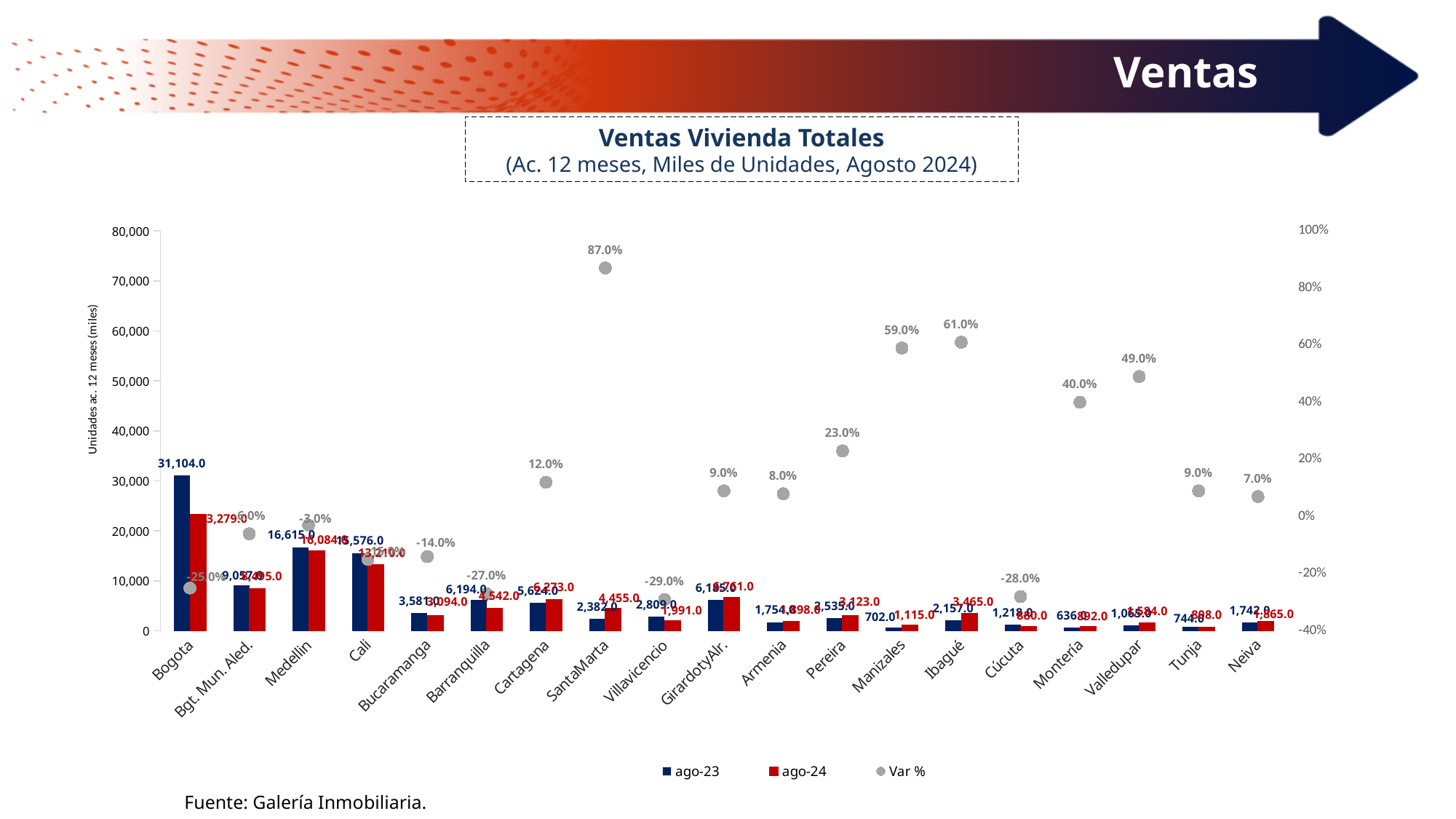
Which city has the highest ago-23 value? Bogota How many series does the legend list? 3 For Cartagena, which is larger: the ago-23 value or the ago-24 value? ago-24 What is the Var % value for SantaMarta? 87.0% What is the source cited below the chart? Galería Inmobiliaria What is the Var % value for Ibagué? 61.0% Is the ago-23 value for Bogota greater or less than 30,000? greater How many cities are shown on the x axis? 19 What is the ago-23 value for Bogota? 31,104.0 Which city has the highest Var % value? SantaMarta What is the difference between the ago-23 and ago-24 values for Bucaramanga? 487.0 What is the ago-24 value for Pereira? 3,123.0